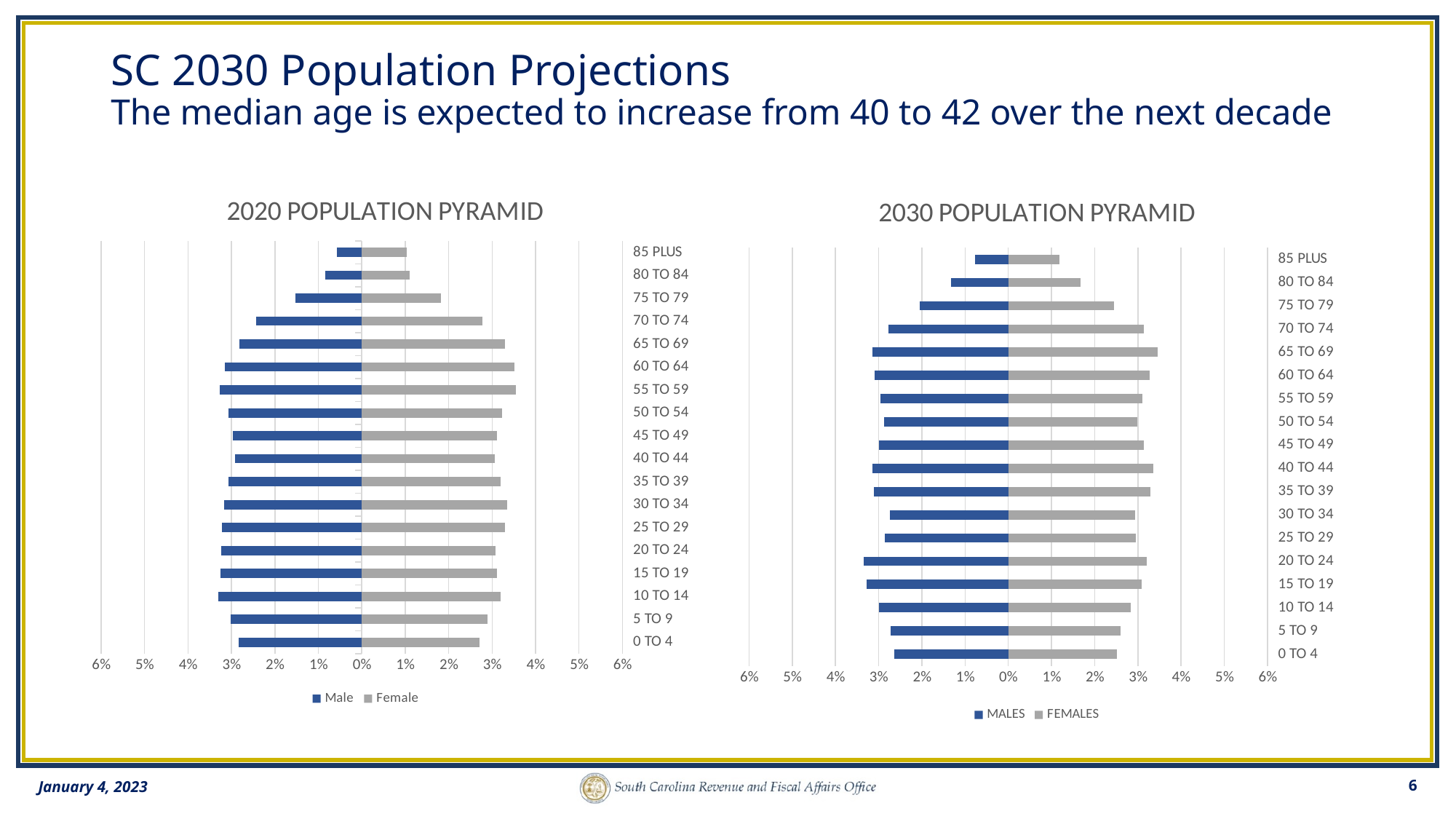
In the 2030 POPULATION PYRAMID, is the MALES value for 0 TO 4 greater or less than 3%? less How many series does the legend of the 2020 POPULATION PYRAMID list? 2 In the 2030 POPULATION PYRAMID, is the FEMALES value for 85 PLUS greater or less than 1%? greater In the 2030 POPULATION PYRAMID, which is larger for 75 TO 79, the MALES value or the FEMALES value? FEMALES In the 2020 POPULATION PYRAMID, which age group has the smallest Male value? 85 PLUS In the 2020 POPULATION PYRAMID, which Female value is larger, 70 TO 74 or 75 TO 79? 70 TO 74 What kind of chart is the 2020 POPULATION PYRAMID? bar chart In the 2020 POPULATION PYRAMID, is the Female value for 55 TO 59 greater or less than 3%? greater In the 2030 POPULATION PYRAMID, which age group has the smallest MALES value? 85 PLUS What are the two legend entries of the 2030 POPULATION PYRAMID? MALES and FEMALES How many age groups are shown in the 2030 POPULATION PYRAMID? 18